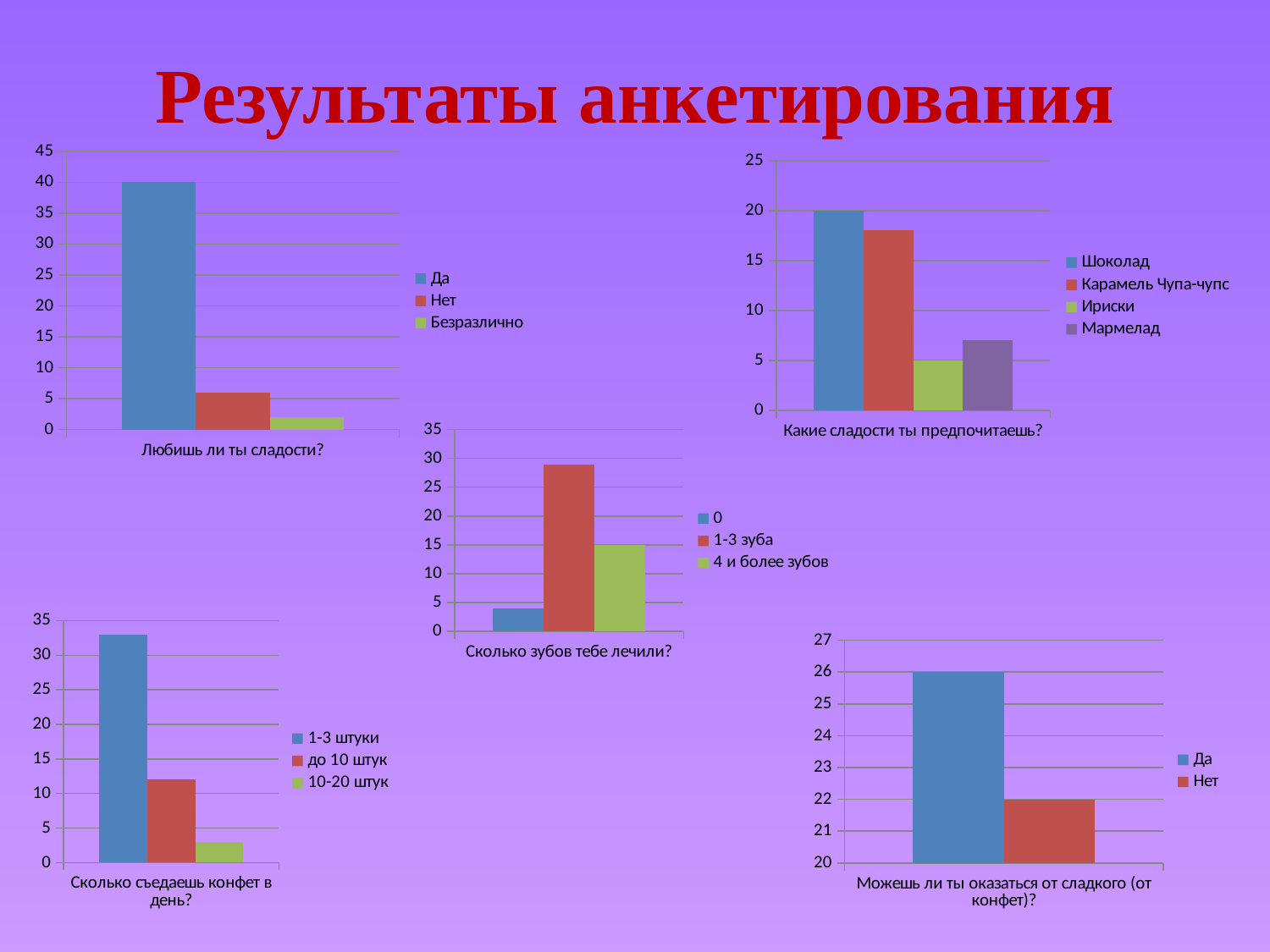
In the chart 'Можешь ли ты отказаться от сладкого (от конфет)?', what is the difference between 'Да' and 'Нет'? 4 In the chart 'Сколько съедаешь конфет в день?', is the value for '1-3 штуки' greater or less than 30? greater In the chart 'Какие сладости ты предпочитаешь?', how many series does the legend list? 4 In the chart 'Сколько зубов тебе лечили?', what is the value for '4 и более зубов'? 15 What type of chart is 'Можешь ли ты отказаться от сладкого (от конфет)?'? bar chart In the chart 'Сколько зубов тебе лечили?', is the value for '0' greater or less than 5? less In the chart 'Какие сладости ты предпочитаешь?', what is the value for 'Ириски'? 5 In the chart 'Любишь ли ты сладости?', what is the value for 'Да'? 40 In the chart 'Любишь ли ты сладости?', which category has the lowest value? Безразлично In the chart 'Сколько зубов тебе лечили?', which category has the highest value? 1-3 зуба In the chart 'Сколько съедаешь конфет в день?', which is larger, 'до 10 штук' or '10-20 штук'? до 10 штук In the chart 'Какие сладости ты предпочитаешь?', what is the value for 'Шоколад'? 20